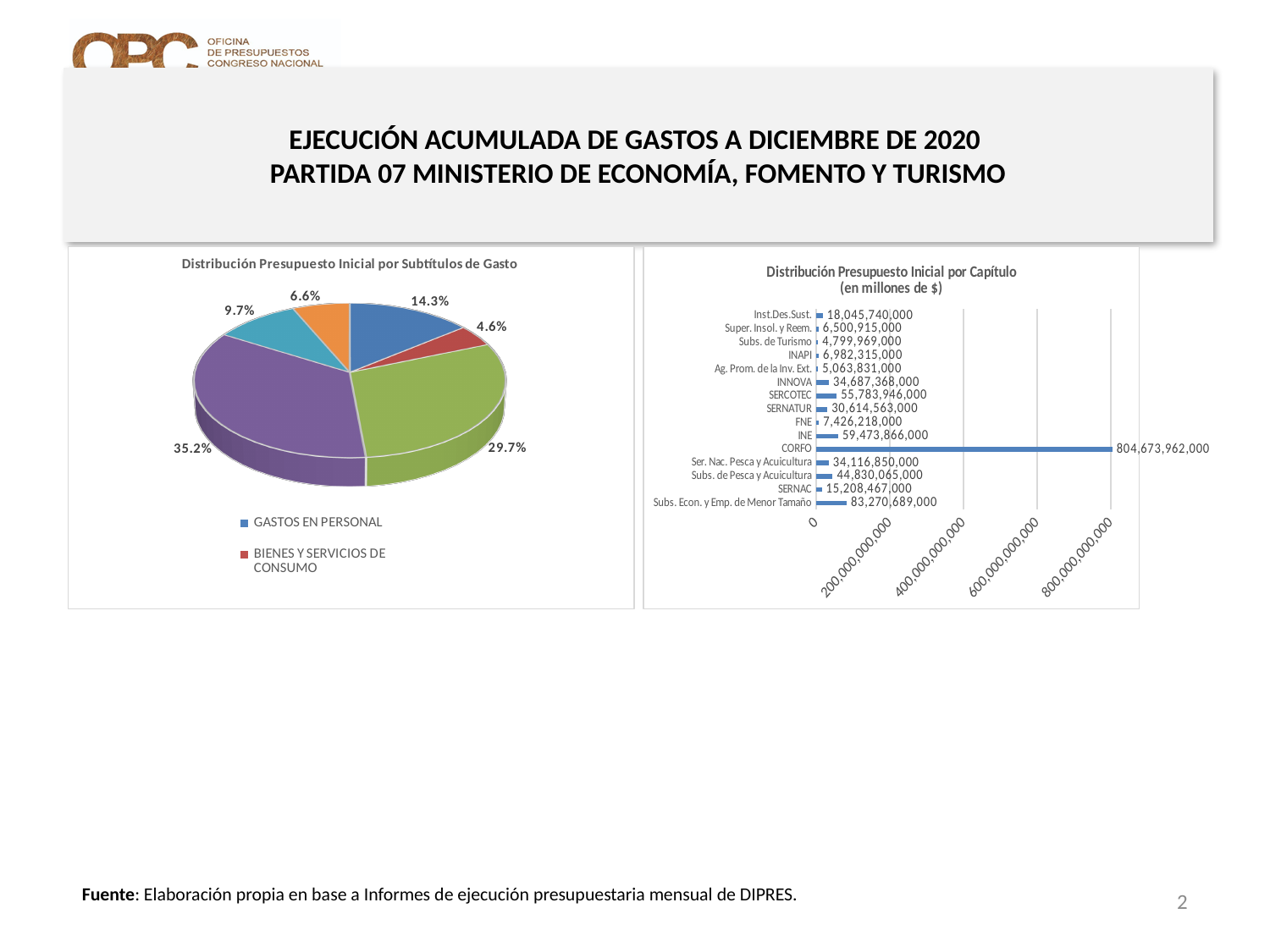
In the chart 'Distribución Presupuesto Inicial por Capítulo', what is the value for SERCOTEC? 55,783,946,000 In the chart 'Distribución Presupuesto Inicial por Capítulo', which category has the lowest value? Subs. de Turismo What kind of chart is 'Distribución Presupuesto Inicial por Capítulo'? Bar chart In the chart 'Distribución Presupuesto Inicial por Capítulo', what is the difference between SERNAC and FNE? 7,782,249,000 In the pie chart 'Distribución Presupuesto Inicial por Subtítulos de Gasto', what share does BIENES Y SERVICIOS DE CONSUMO have? 4.6% In the chart 'Distribución Presupuesto Inicial por Capítulo', what is the value for CORFO? 804,673,962,000 In the chart 'Distribución Presupuesto Inicial por Capítulo', how many categories are shown? 15 In the chart 'Distribución Presupuesto Inicial por Capítulo', which category has the highest value? CORFO In the chart 'Distribución Presupuesto Inicial por Capítulo', what is the value for Subs. de Turismo? 4,799,969,000 In the pie chart 'Distribución Presupuesto Inicial por Subtítulos de Gasto', what is the largest percentage shown? 35.2% In the pie chart 'Distribución Presupuesto Inicial por Subtítulos de Gasto', what share does GASTOS EN PERSONAL have? 14.3% In the chart 'Distribución Presupuesto Inicial por Capítulo', which is larger, INE or INNOVA? INE